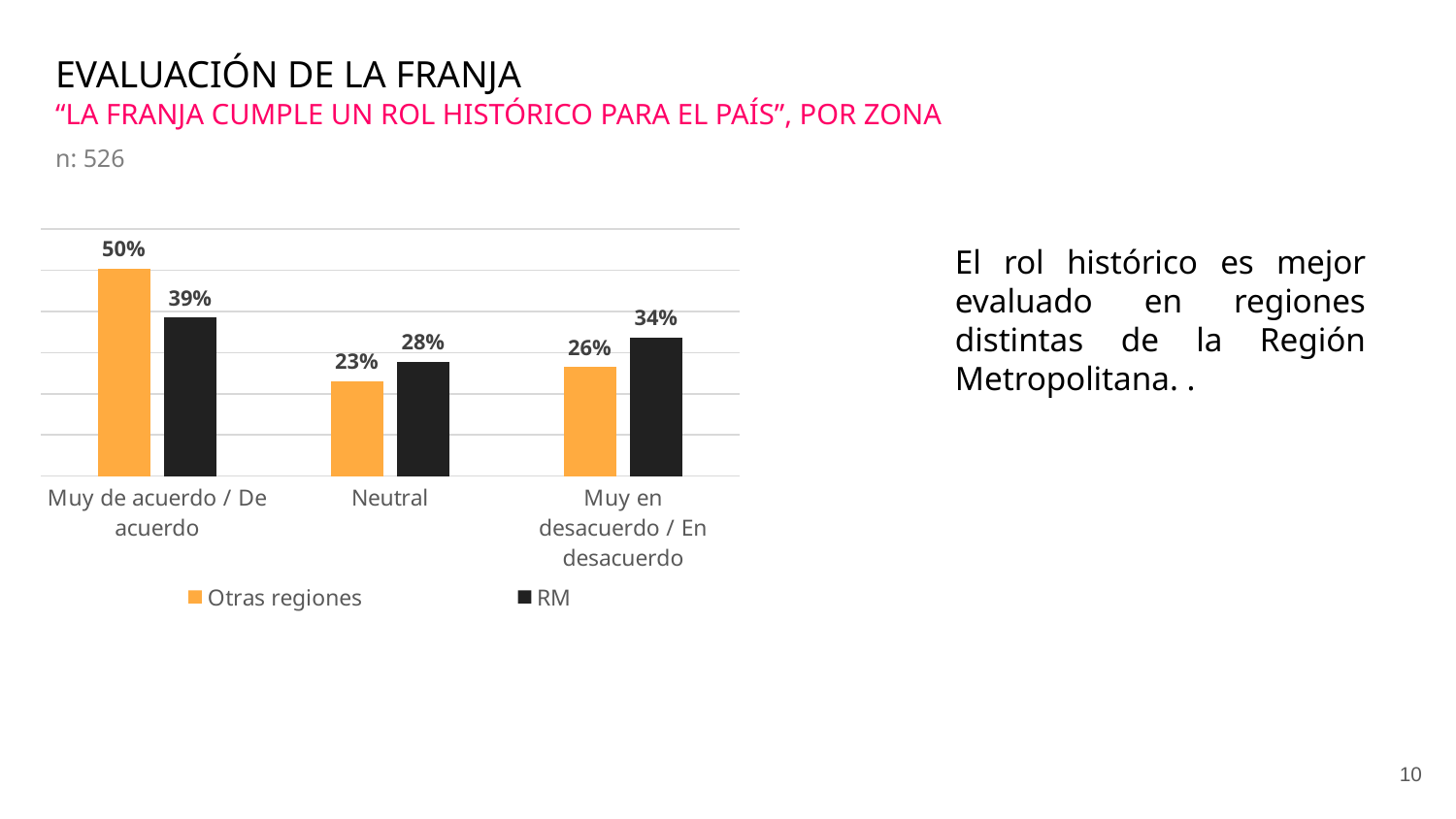
What is the value for RM in the Muy en desacuerdo / En desacuerdo category? 34% What colour are the bars for the RM series? Black Which category has the lowest value for RM? Neutral What kind of chart is shown on the slide? Bar chart Which series has the larger value in the Muy en desacuerdo / En desacuerdo category, Otras regiones or RM? RM What is the value for RM in the Neutral category? 28% What is the value for Otras regiones in the Neutral category? 23% What is the value for Otras regiones in the Muy de acuerdo / De acuerdo category? 50% What is the difference between Otras regiones and RM in the Muy de acuerdo / De acuerdo category? 11% Which category has the highest value for Otras regiones? Muy de acuerdo / De acuerdo How many series does the legend list? 2 How many categories are shown on the x axis? 3